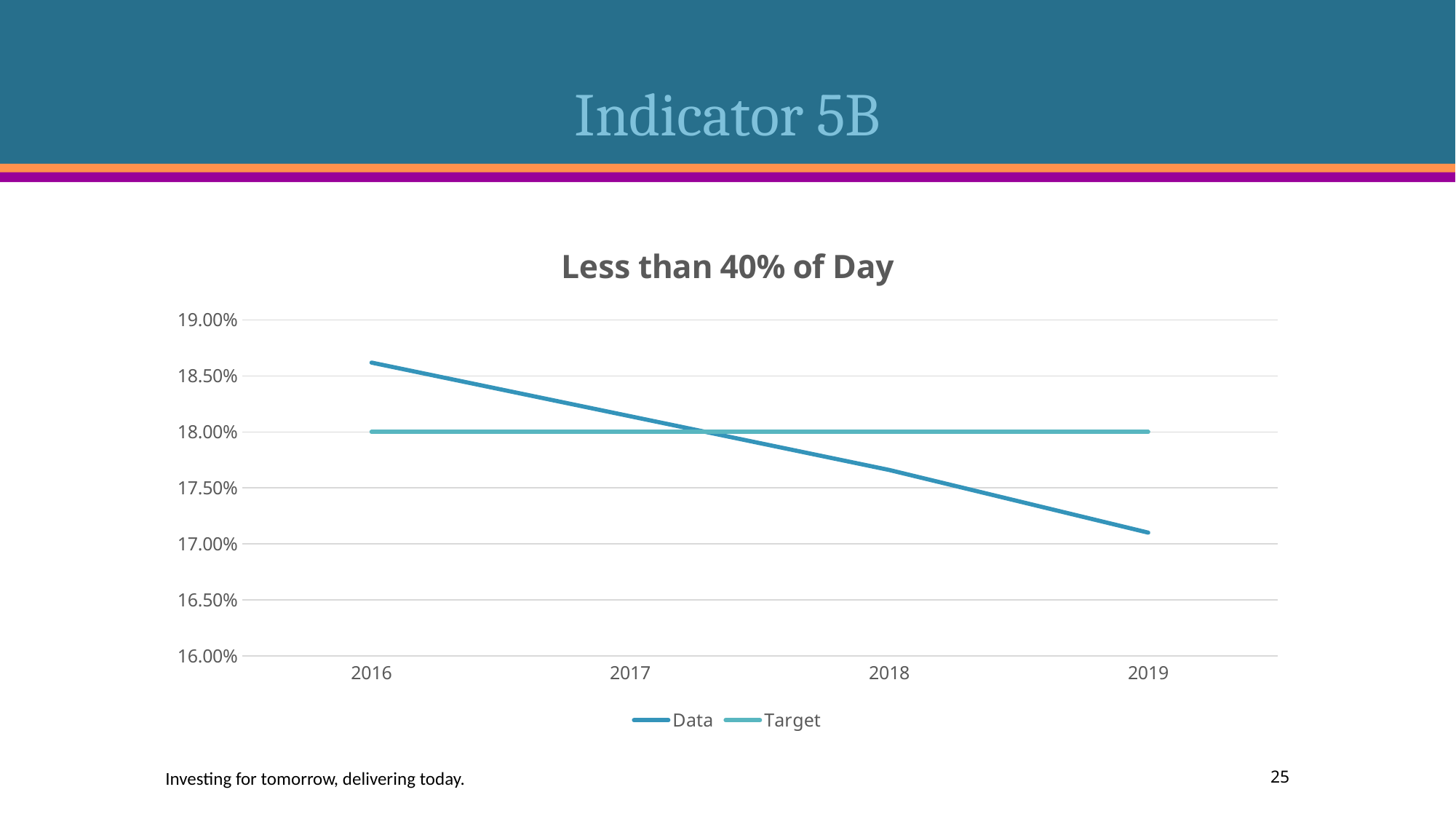
Is the Data value for 2019 greater or less than 17.50%? less What kind of chart is shown on the slide? line chart In which year is the Data series lowest? 2019 How many years are plotted along the x axis? 4 What is the title of the chart? Less than 40% of Day Is the Data value for 2018 greater or less than 18.00%? less How many series does the legend list? 2 What is the value of the Target series in 2017? 18.00% In 2019, which is larger: the Data value or the Target value? Target Is the Data value for 2016 greater or less than 18.00%? greater Does the Data series rise or fall from 2016 to 2019? fall In which year is the Data series highest? 2016